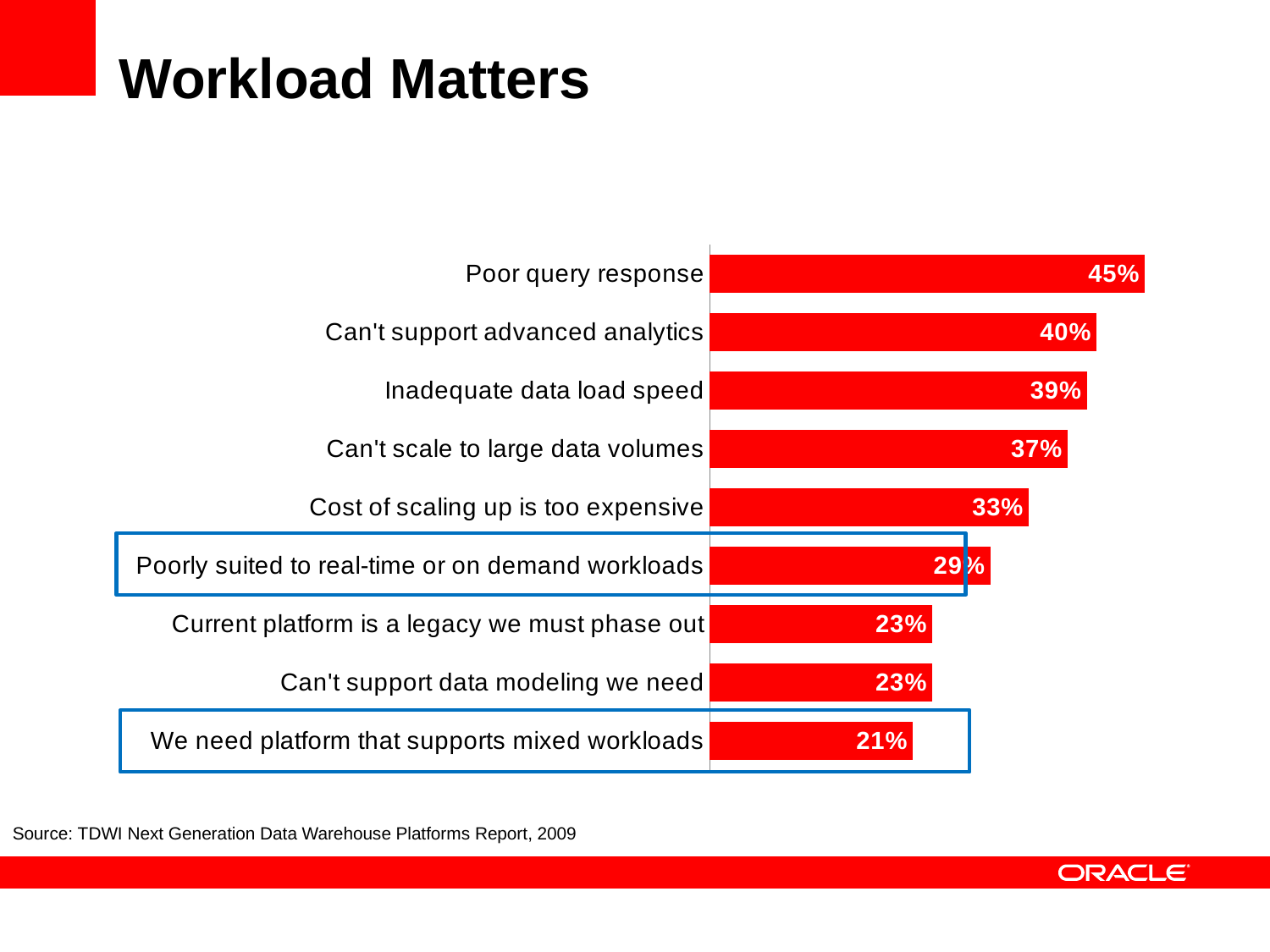
How many categories are shown in the chart? 9 Which is larger, the value for Can't scale to large data volumes or the value for Cost of scaling up is too expensive? Can't scale to large data volumes What is the value for Poor query response? 45% What is the title of the slide containing the chart? Workload Matters What kind of chart is shown on the slide? Bar chart What is the value for Cost of scaling up is too expensive? 33% What is the value for We need platform that supports mixed workloads? 21% Which category has the lowest value? We need platform that supports mixed workloads Which category has the highest value? Poor query response What is the value for Poorly suited to real-time or on demand workloads? 29% What is the difference between the values for Inadequate data load speed and Current platform is a legacy we must phase out? 16% What is the difference between the values for Poor query response and Can't support advanced analytics? 5%